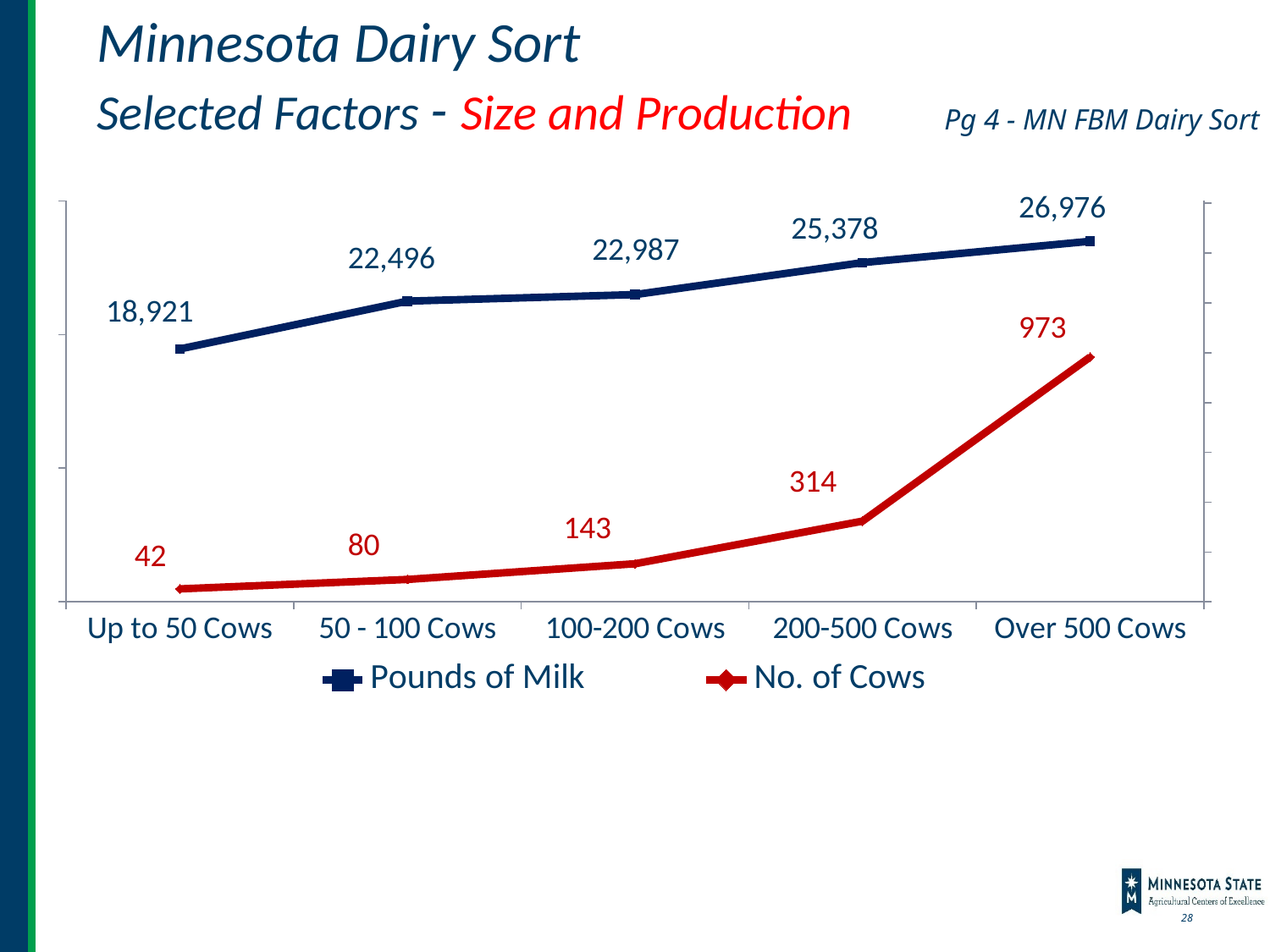
What is the difference in Pounds of Milk between Over 500 Cows and Up to 50 Cows? 8,055 Which is larger, the Pounds of Milk value for 100-200 Cows or for 50 - 100 Cows? 100-200 Cows Which category has the lowest Pounds of Milk value? Up to 50 Cows How many series does the legend list? 2 What is the Pounds of Milk value for Over 500 Cows? 26,976 What is the Pounds of Milk value for the 50 - 100 Cows category? 22,496 Do the No. of Cows values rise or fall from Up to 50 Cows to Over 500 Cows? Rise What is the difference in No. of Cows between 200-500 Cows and 100-200 Cows? 171 What kind of chart is shown on the slide? Line chart What is the No. of Cows value for the 200-500 Cows category? 314 Which category has the highest No. of Cows value? Over 500 Cows How many categories are shown on the x axis? 5